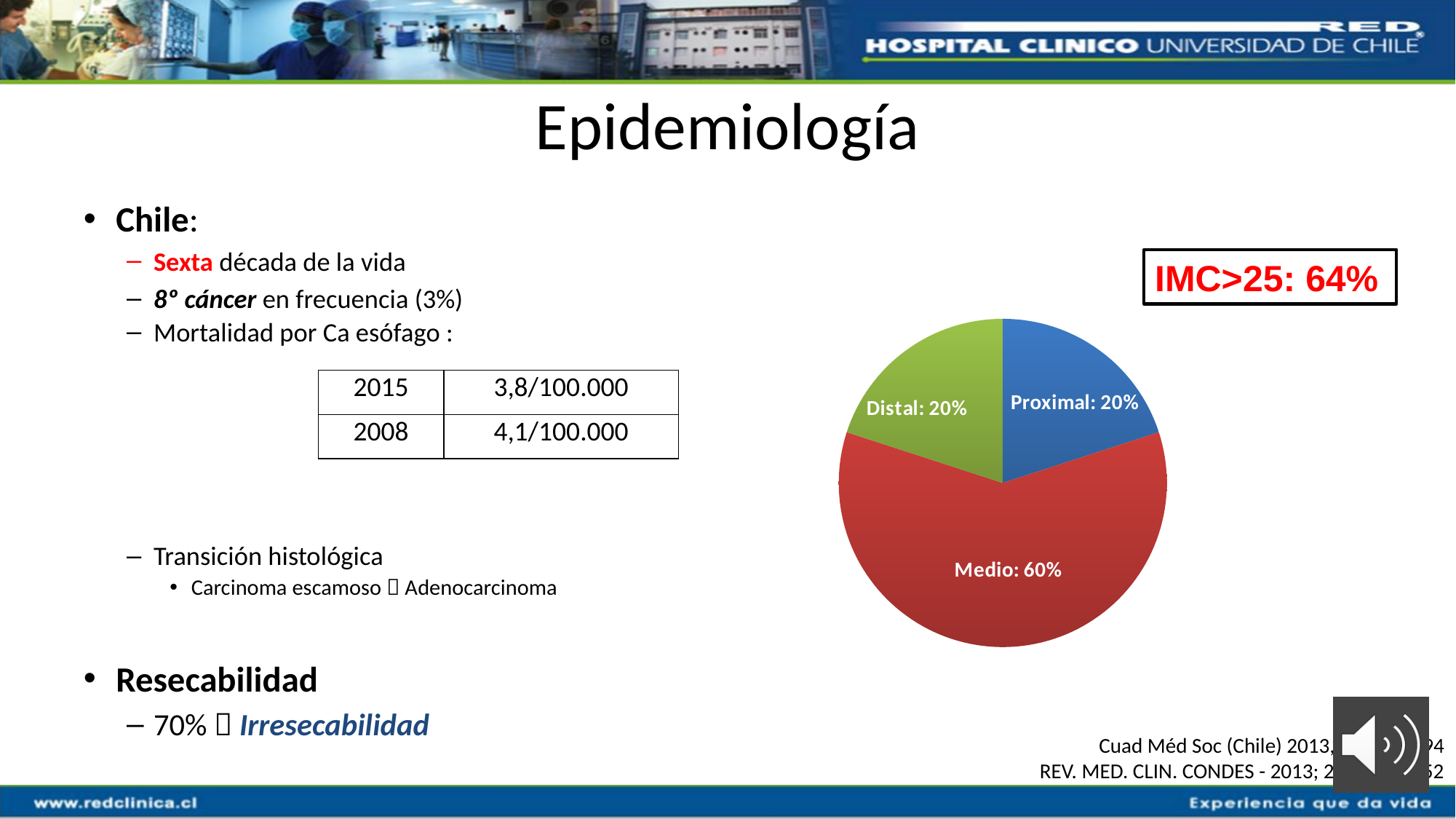
How many slices does the pie chart have? 3 What share of the pie does the Distal slice represent? 20% Which is larger, the Medio slice or the Proximal slice? Medio What kind of chart is shown on the slide? pie chart What share of the pie does the Proximal slice represent? 20% What is the difference in percentage points between the Medio slice and the Distal slice? 40 What colour is the Medio slice in the pie chart? red What colour is the Distal slice in the pie chart? green What share of the pie does the Medio slice represent? 60% What is the combined share of the Proximal and Distal slices? 40% Which slice of the pie chart is the largest? Medio